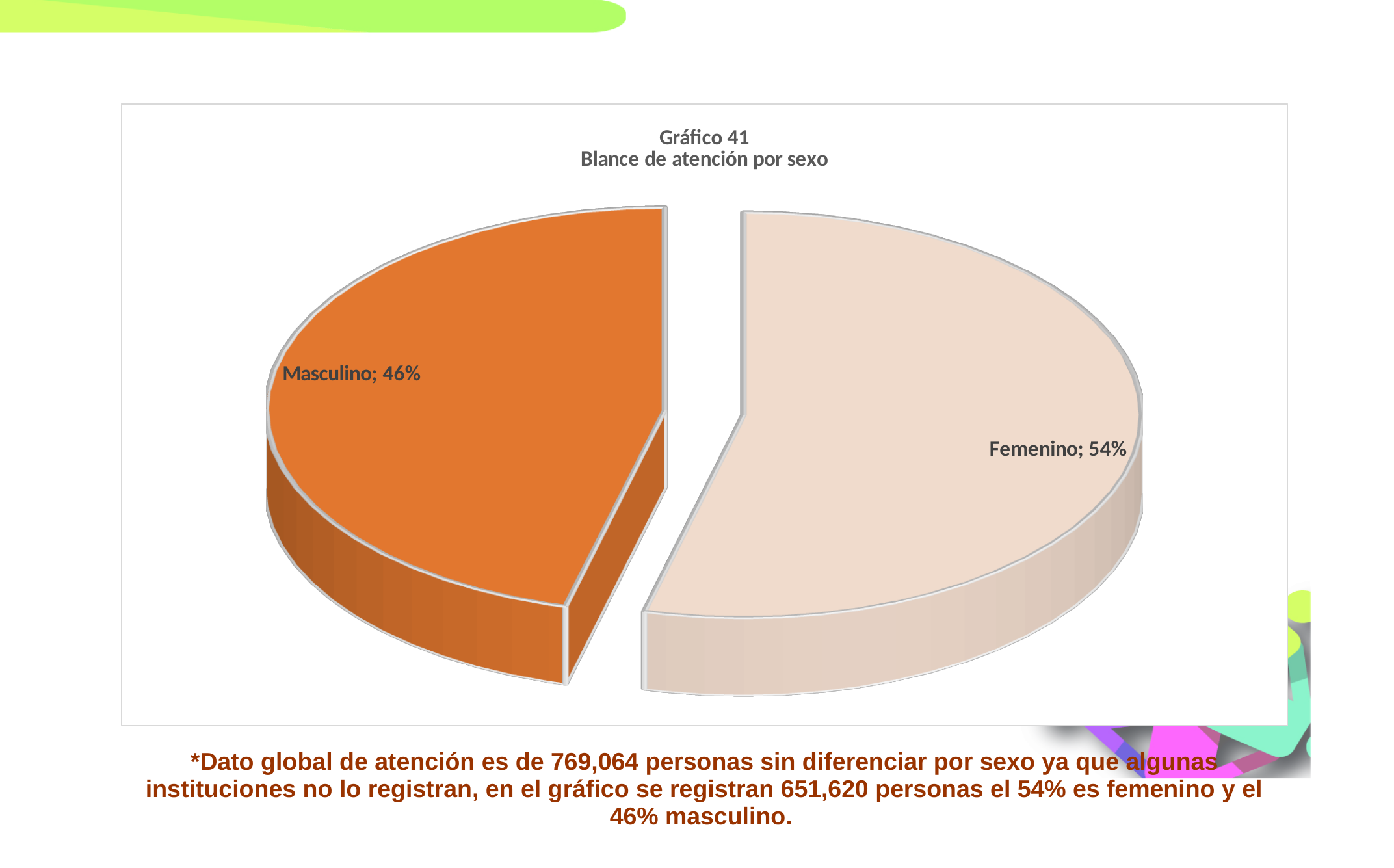
Which category has the largest slice of the pie? Femenino Is the value for Femenino greater or less than 50%? greater Which slice is larger, Femenino or Masculino? Femenino How many slices does the pie chart have? 2 Which category has the smallest slice of the pie? Masculino What is the title of the chart? Gráfico 41 Blance de atención por sexo What share of the pie does Masculino represent? 46% What share of the pie does Femenino represent? 54% What kind of chart is shown on the slide? Pie chart What is the difference in percentage points between the Femenino and Masculino slices? 8% What colour is the Masculino slice? Orange Is the value for Masculino greater or less than 50%? less